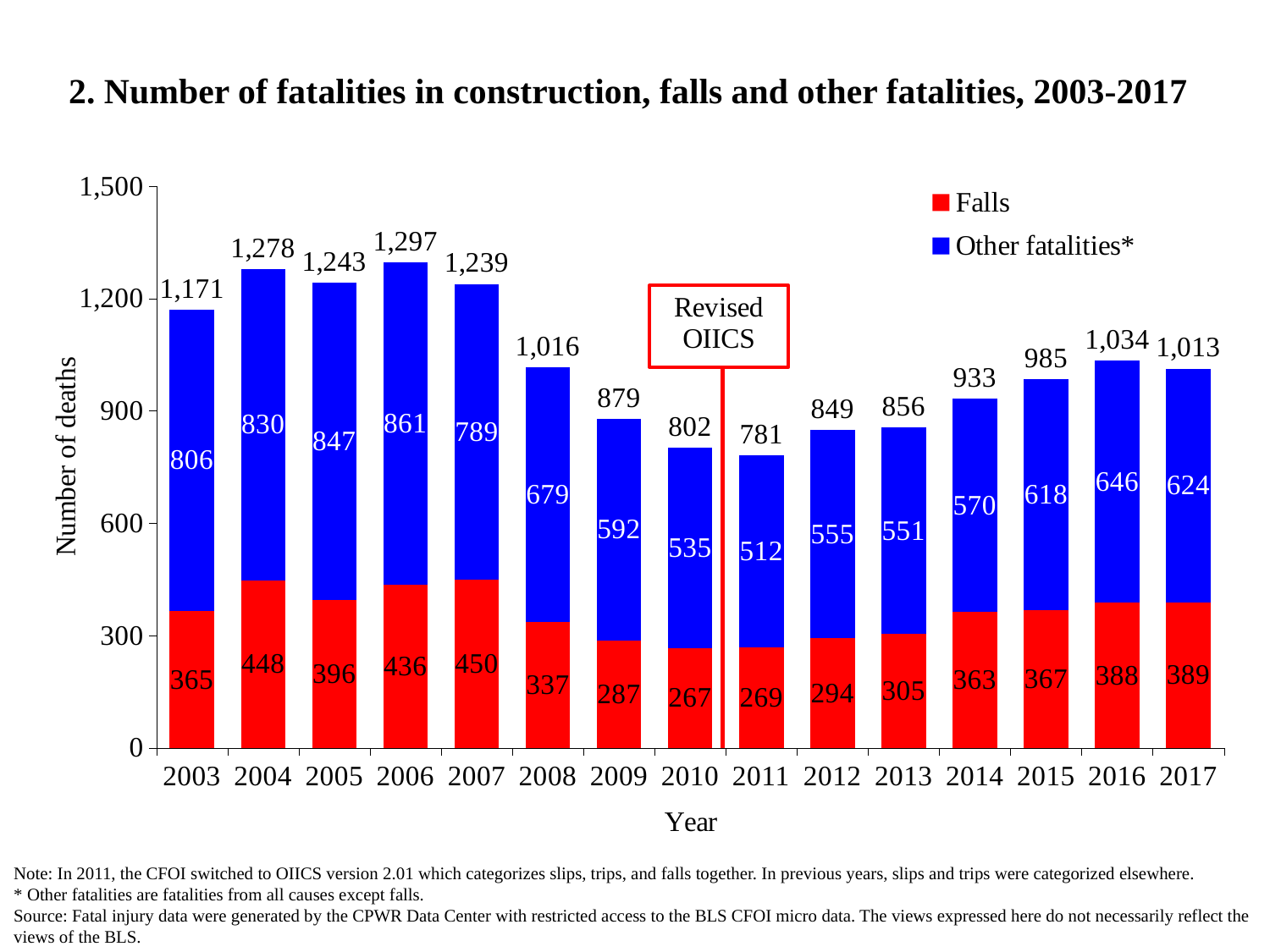
Which is larger, the number of falls in 2004 or in 2014? 2004 Which year has the highest total number of fatalities? 2006 What is the number of other fatalities in 2016? 646 Is the total number of fatalities in 2011 greater or less than 900? less What is the difference between the total fatalities in 2003 and 2017? 158 How many years are shown on the x axis? 15 What colour represents Falls in the chart? red What is the number of falls fatalities in 2007? 450 Which year has the lowest number of falls fatalities? 2010 What kind of chart is shown? stacked bar chart How many series does the legend list? 2 What is the total number of fatalities in 2006? 1,297